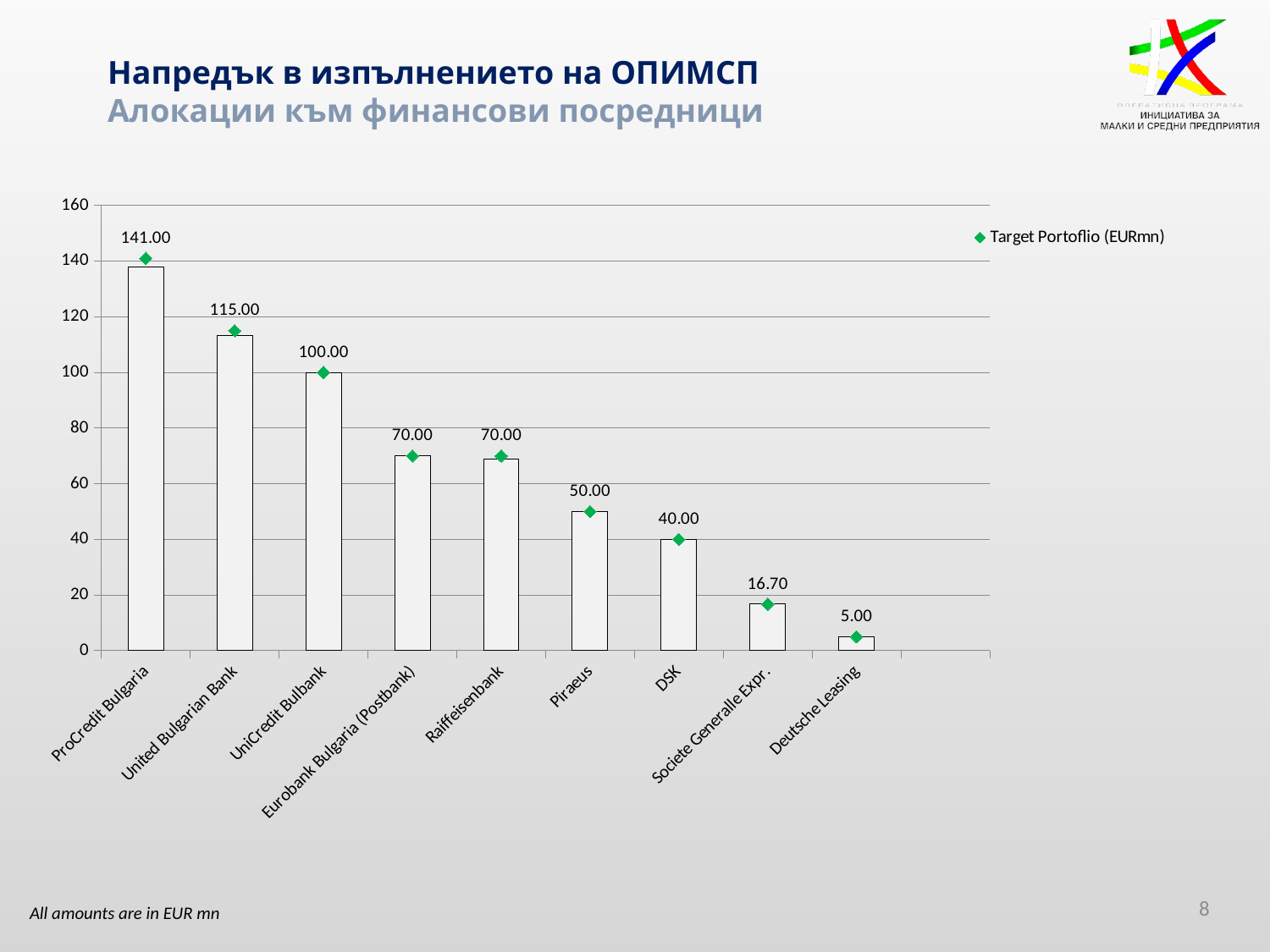
Which has a larger Target Portoflio (EURmn) value, Piraeus or DSK? Piraeus What is the difference between the Target Portoflio (EURmn) values for ProCredit Bulgaria and UniCredit Bulbank? 41.00 What is the Target Portoflio (EURmn) value for ProCredit Bulgaria? 141.00 What is the Target Portoflio (EURmn) value for DSK? 40.00 How many financial intermediaries are shown on the x axis of the chart? 9 What is the Target Portoflio (EURmn) value for United Bulgarian Bank? 115.00 Which financial intermediary has the lowest Target Portoflio (EURmn) value? Deutsche Leasing What is the legend entry shown on the chart? Target Portoflio (EURmn) How many series does the chart legend list? 1 Do the Target Portoflio (EURmn) values rise or fall from left to right along the x axis? fall Which financial intermediary has the highest Target Portoflio (EURmn) value? ProCredit Bulgaria What is the Target Portoflio (EURmn) value for Societe Generalle Expr.? 16.70